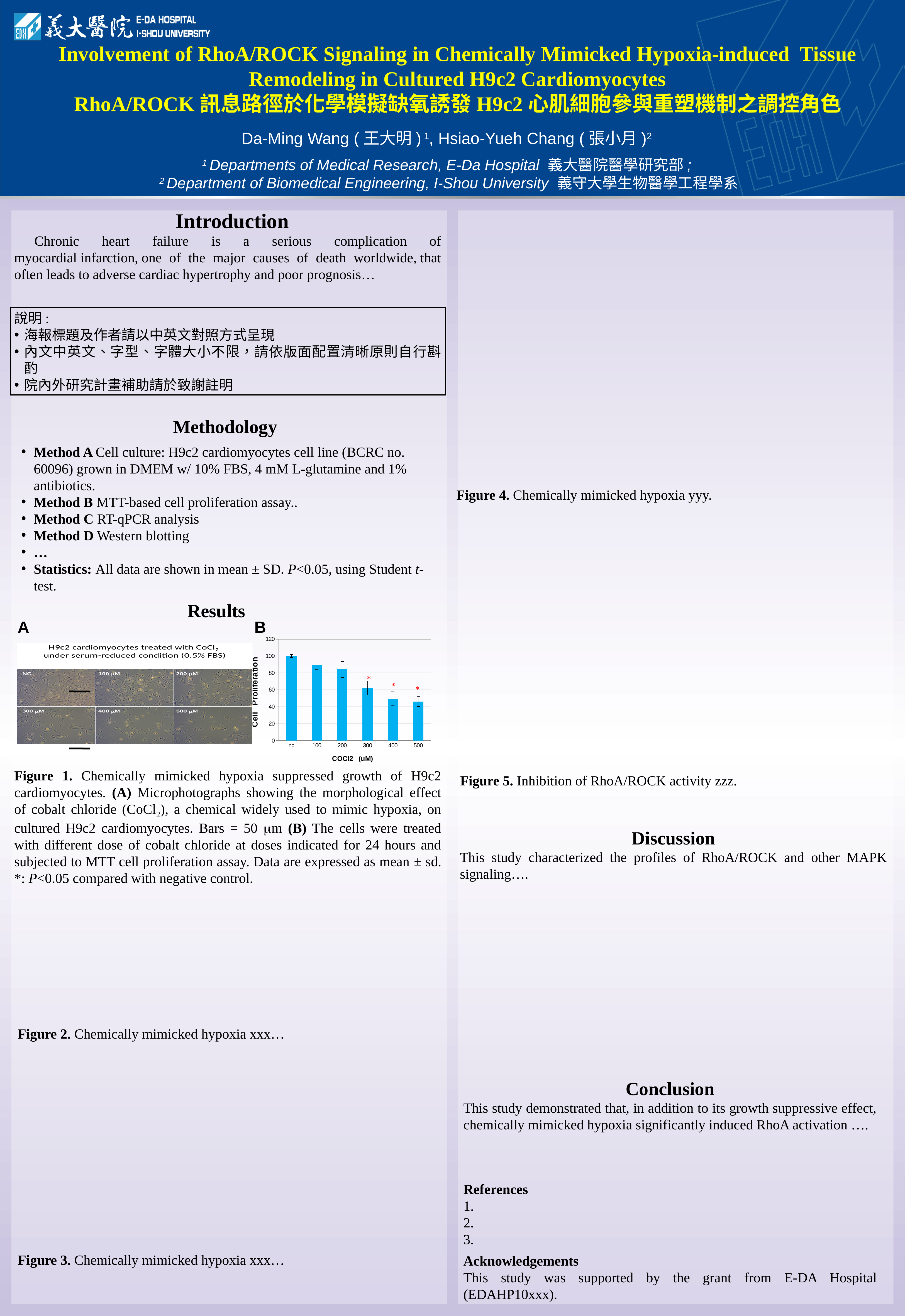
In the Figure 1B chart, which has the larger cell proliferation value, nc or 300 uM CoCl2? nc In the Figure 1B chart, which category has the highest cell proliferation? nc In the Figure 1B chart, is the cell proliferation value for 500 uM CoCl2 greater or less than 60? less In the Figure 1B chart, is the cell proliferation value for 400 uM CoCl2 greater or less than 60? less In the Figure 1B chart, is the cell proliferation value for 100 uM CoCl2 greater or less than 60? greater In the Figure 1B chart, how many CoCl2 dose categories are plotted on the x axis? 6 In the Figure 1B chart, do the cell proliferation values rise or fall as the CoCl2 dose increases along the x axis? fall What is the x-axis title of the Figure 1B chart? COCl2 (uM) What kind of chart is shown in Figure 1B? bar chart What is the y-axis title of the Figure 1B chart? Cell Proliferation In the Figure 1B chart, which has the larger cell proliferation value, 100 uM or 400 uM CoCl2? 100